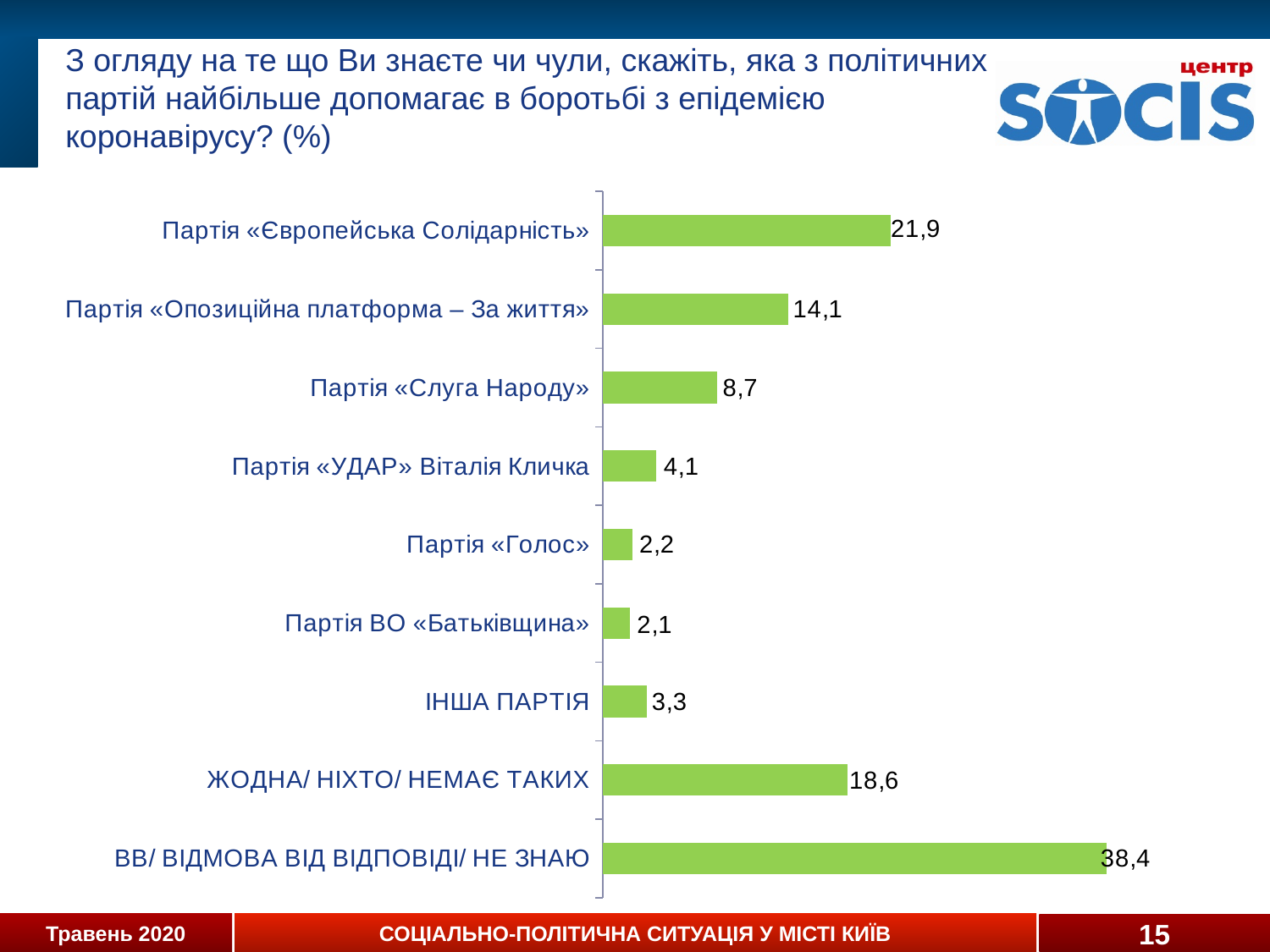
What is the value for Партія «Європейська Солідарність»? 21,9 What is the value for Партія «Слуга Народу»? 8,7 What is the value for Партія «УДАР» Віталія Кличка? 4,1 Which is larger, the value for Партія «Слуга Народу» or the value for ІНША ПАРТІЯ? Партія «Слуга Народу» How many categories are shown in the chart? 9 What is the difference between the values for Партія «Європейська Солідарність» and Партія «Опозиційна платформа – За життя»? 7,8 What is the difference between the values for ВВ/ ВІДМОВА ВІД ВІДПОВІДІ/ НЕ ЗНАЮ and ЖОДНА/ НІХТО/ НЕМАЄ ТАКИХ? 19,8 Which category has the highest value? ВВ/ ВІДМОВА ВІД ВІДПОВІДІ/ НЕ ЗНАЮ What is the value for ЖОДНА/ НІХТО/ НЕМАЄ ТАКИХ? 18,6 Which category has the lowest value? Партія ВО «Батьківщина» What colour are the bars in the chart? green What type of chart is shown on the slide? bar chart